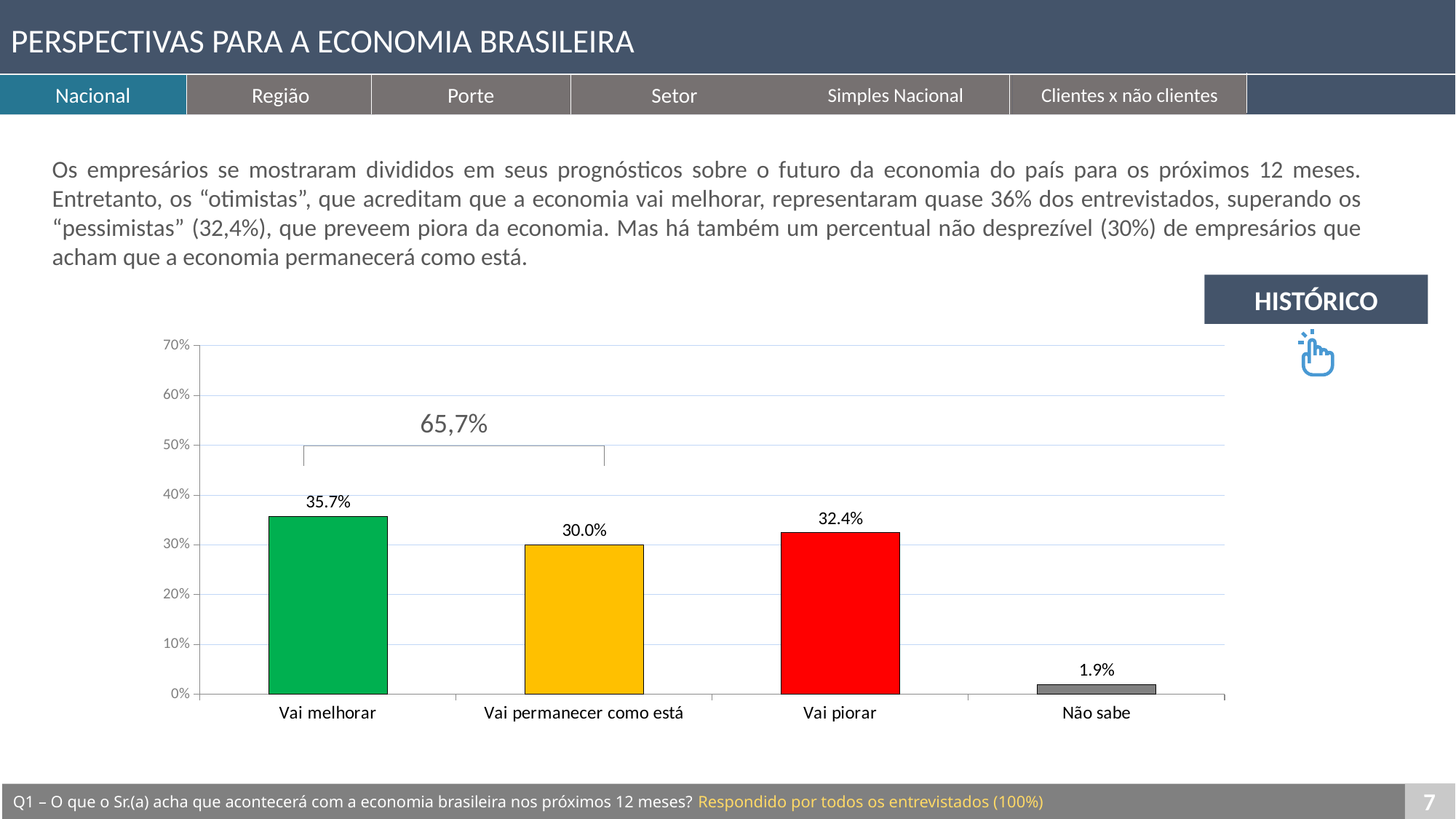
Is the value for "Vai melhorar" greater or less than 40%? less How many categories are shown on the x axis? 4 What is the value for "Vai permanecer como está"? 30.0% What combined percentage is shown by the bracket above the first two bars? 65,7% Which category has the highest value? Vai melhorar What is the difference between the values for "Vai melhorar" and "Vai piorar"? 3.3% What is the value for "Vai melhorar"? 35.7% What is the value for "Vai piorar"? 32.4% What is the value for "Não sabe"? 1.9% What kind of chart is shown on the slide? bar chart Which is larger, the value for "Vai piorar" or the value for "Vai permanecer como está"? Vai piorar Which category has the lowest value? Não sabe